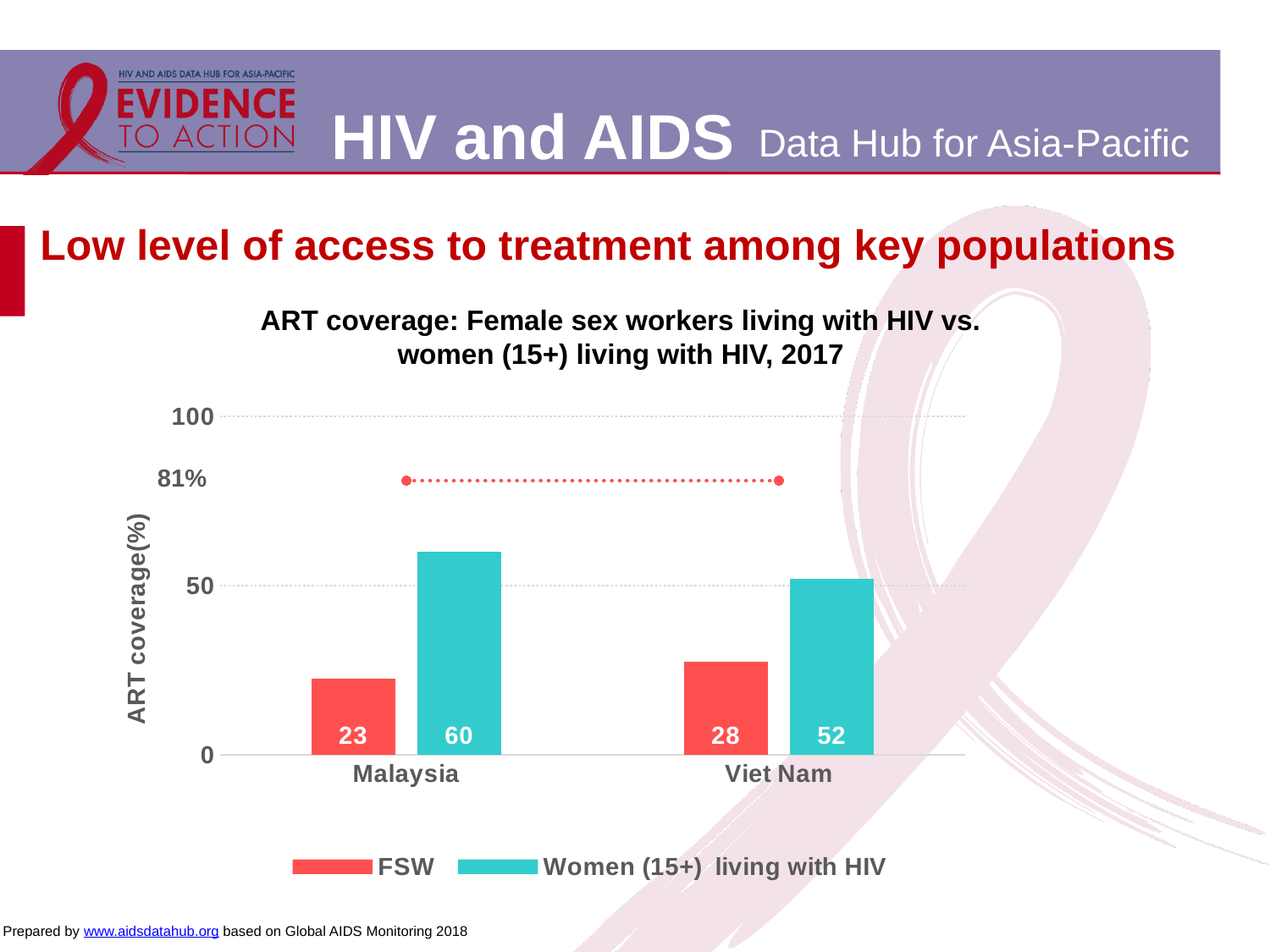
How many countries are shown on the x axis of the chart? 2 How many series does the legend list? 2 Which country has the higher ART coverage for Women (15+) living with HIV? Malaysia What kind of chart is shown on the slide? Bar chart What is the difference between ART coverage for Women (15+) living with HIV and FSW in Malaysia? 37 What is the ART coverage value for Women (15+) living with HIV in Malaysia? 60 What is the ART coverage value for FSW in Viet Nam? 28 What is the ART coverage value for FSW in Malaysia? 23 What is the ART coverage value for Women (15+) living with HIV in Viet Nam? 52 Is the ART coverage value for FSW in Viet Nam greater or less than 50? less Which country has the higher ART coverage for FSW? Viet Nam What is the difference between ART coverage for Women (15+) living with HIV and FSW in Viet Nam? 24